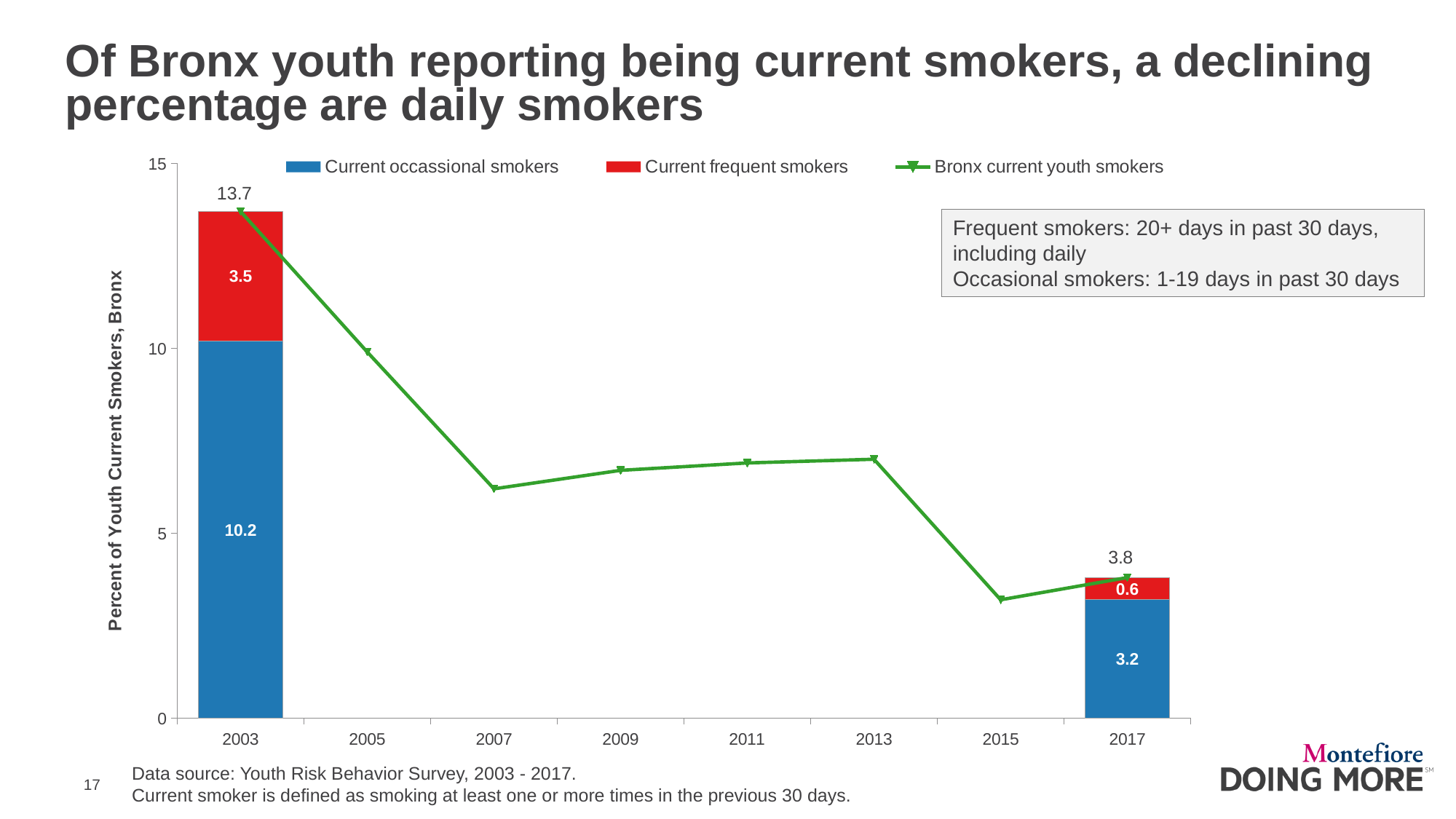
Which year has the larger Current frequent smokers value, 2003 or 2017? 2003 What is the total of the stacked bar for 2003? 13.7 Is the Bronx current youth smokers value for 2007 greater or less than 10? less In which year is the Bronx current youth smokers value highest? 2003 How many years are shown on the x axis? 8 How many series does the legend list? 3 What is the value for Current frequent smokers in 2017? 0.6 Is the Bronx current youth smokers value for 2015 greater or less than 5? less What is the value for Current occassional smokers in 2003? 10.2 What is the difference between the Current frequent smokers values for 2003 and 2017? 2.9 What is the difference between the Current occassional smokers values for 2003 and 2017? 7.0 Does the Bronx current youth smokers line rise or fall from 2003 to 2017? fall